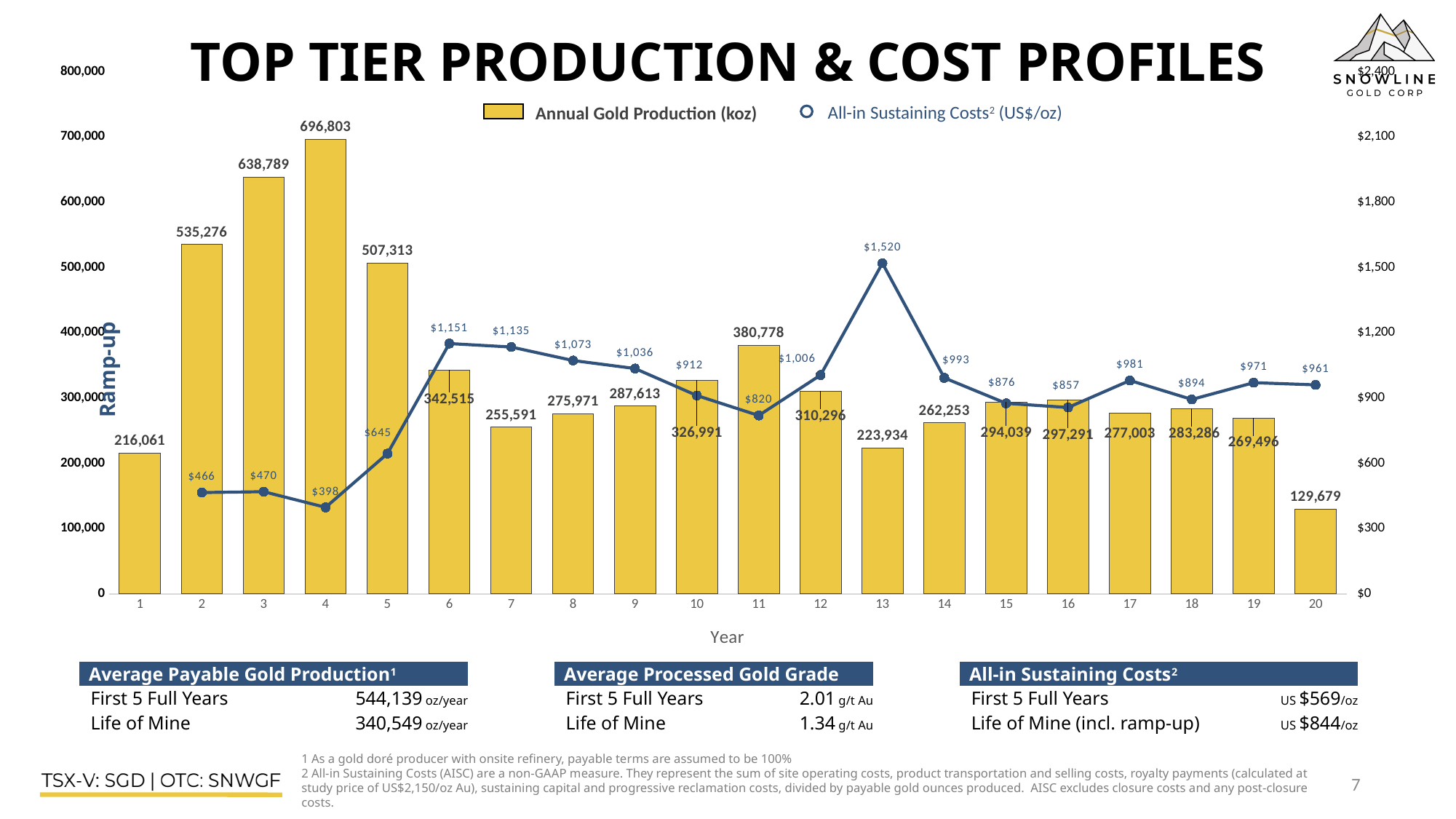
How many years are shown on the x axis? 20 What is the difference in annual gold production between year 3 and year 2? 103,513 Which year has the highest annual gold production? 4 Which year has higher annual gold production, year 10 or year 12? 10 What is the title of the chart? TOP TIER PRODUCTION & COST PROFILES Which year has the lowest annual gold production? 20 What is the annual gold production in year 11? 380,778 What is the All-in Sustaining Cost in year 4? $398 What is the annual gold production in year 4? 696,803 Which year has the highest All-in Sustaining Cost? 13 What is the All-in Sustaining Cost in year 13? $1,520 How many series does the legend list? 2